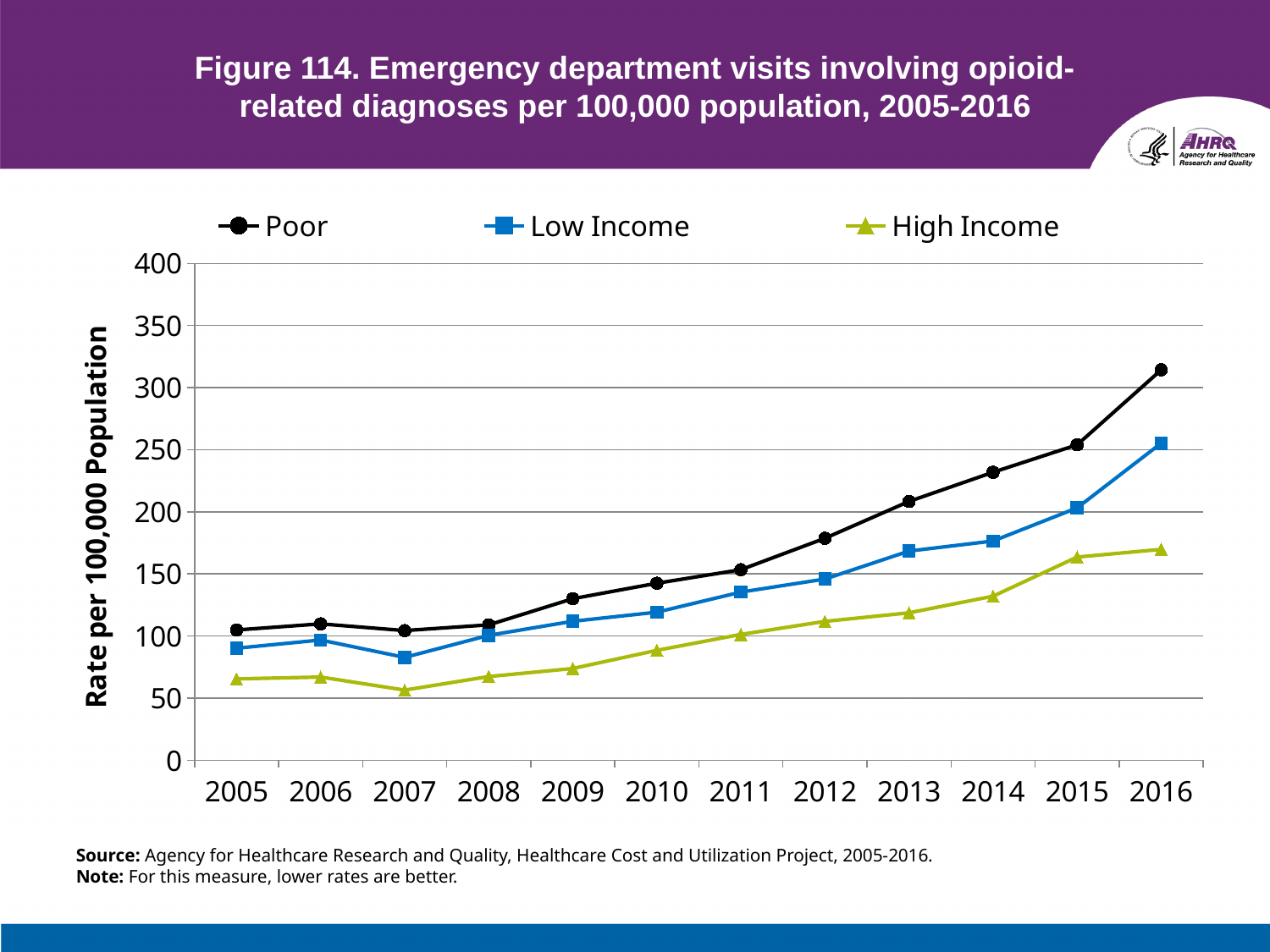
Is the value for Low Income in 2007 greater or less than 100? less How many years are plotted along the x axis? 12 How many series does the legend list? 3 Is the value for Poor in 2016 greater or less than 300? greater Which series has the lowest rate in 2016? High Income Is the value for High Income in 2016 greater or less than 200? less Which is larger in 2013, the rate for Low Income or the rate for High Income? Low Income Do the rates for the Poor series generally rise or fall from 2005 to 2016? Rise In which year is the Poor series at its highest? 2016 Which series has the highest rate in 2016? Poor What kind of chart is shown on the slide? Line chart In which year is the High Income series at its lowest? 2007